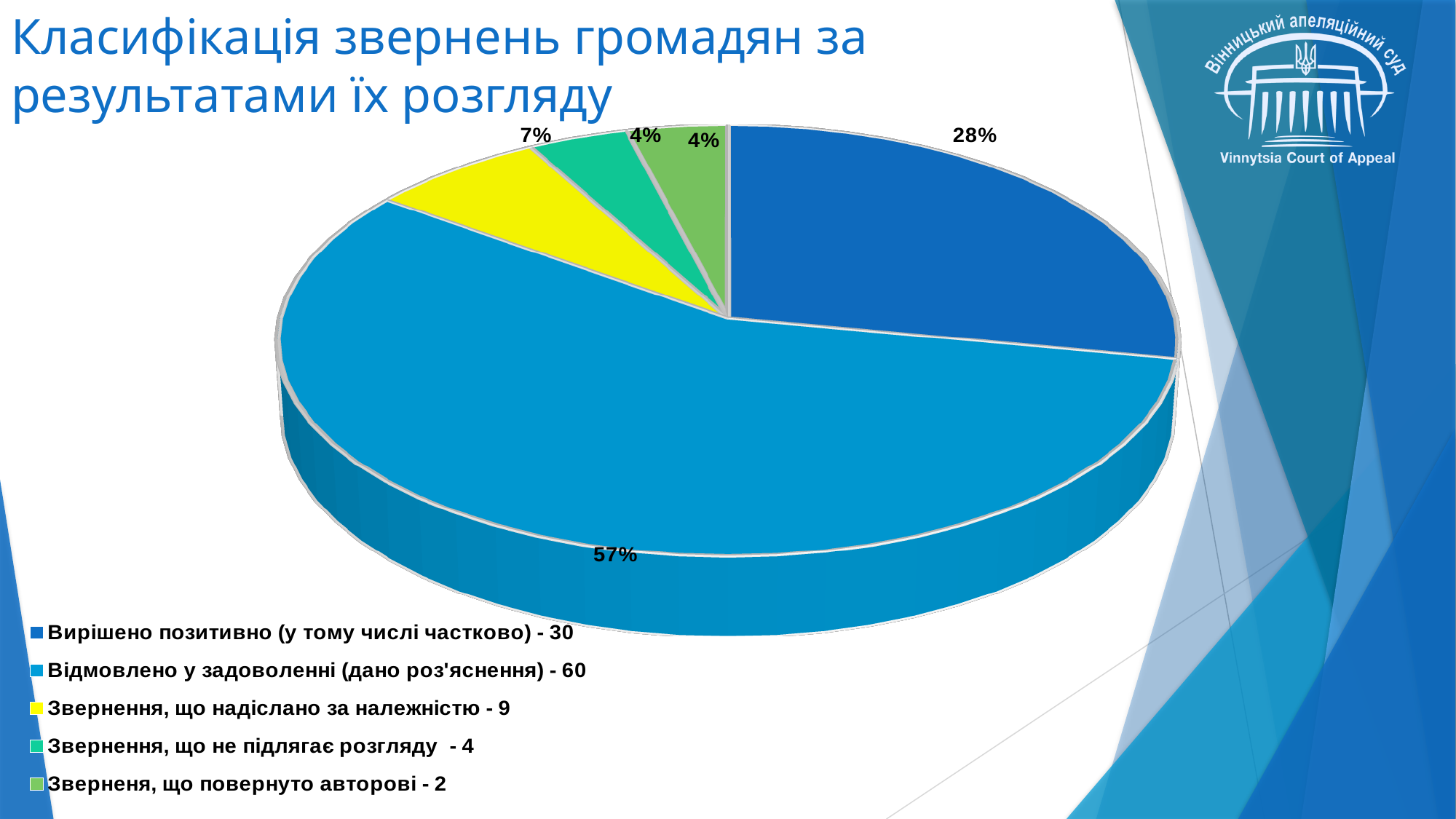
What colour is the slice for "Звернення, що надіслано за належністю"? yellow What share of the pie is labelled for "Звернення, що надіслано за належністю"? 7% How many slices does the pie chart have? 5 According to the legend, how many appeals were "Відмовлено у задоволенні (дано роз'яснення)"? 60 According to the legend, how many appeals were "Звернення, що надіслано за належністю"? 9 Which category has the largest slice of the pie? Відмовлено у задоволенні (дано роз'яснення) What share of the pie is labelled for "Відмовлено у задоволенні (дано роз'яснення)"? 57% Which of the two is larger: the slice for "Вирішено позитивно" or the slice for "Відмовлено у задоволенні"? Відмовлено у задоволенні According to the counts in the legend, which category has the fewest appeals? Зверненя, що повернуто авторові - 2 What is the difference in percentage points between the 57% slice and the 28% slice? 29% What share of the pie is labelled for "Вирішено позитивно (у тому числі частково)"? 28% What kind of chart is shown on the slide? pie chart